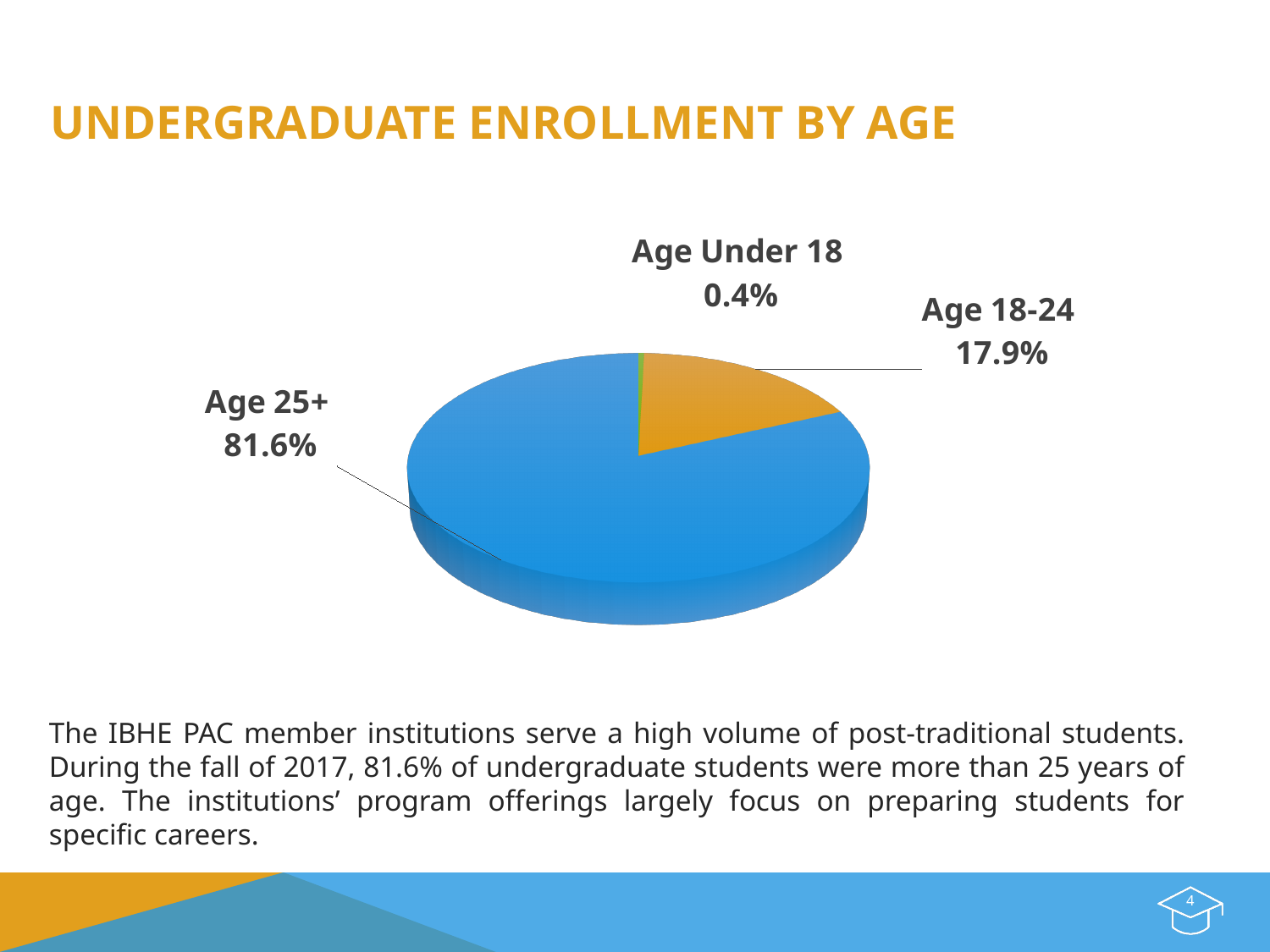
Which age group has the largest share of undergraduate enrollment? Age 25+ What share of undergraduate enrollment is Age 25+? 81.6% What colour is the Age 25+ slice of the pie chart? Blue What is the title of the chart on the slide? Undergraduate Enrollment by Age What share of undergraduate enrollment is Age Under 18? 0.4% What is the difference in percentage points between the Age 18-24 and Age Under 18 shares? 17.5 Which is larger, the share for Age 18-24 or the share for Age Under 18? Age 18-24 How many age groups are shown in the pie chart? 3 What is the difference in percentage points between the Age 25+ and Age 18-24 shares? 63.7 What kind of chart is shown on the slide? Pie chart What share of undergraduate enrollment is Age 18-24? 17.9% Which age group has the smallest share of undergraduate enrollment? Age Under 18